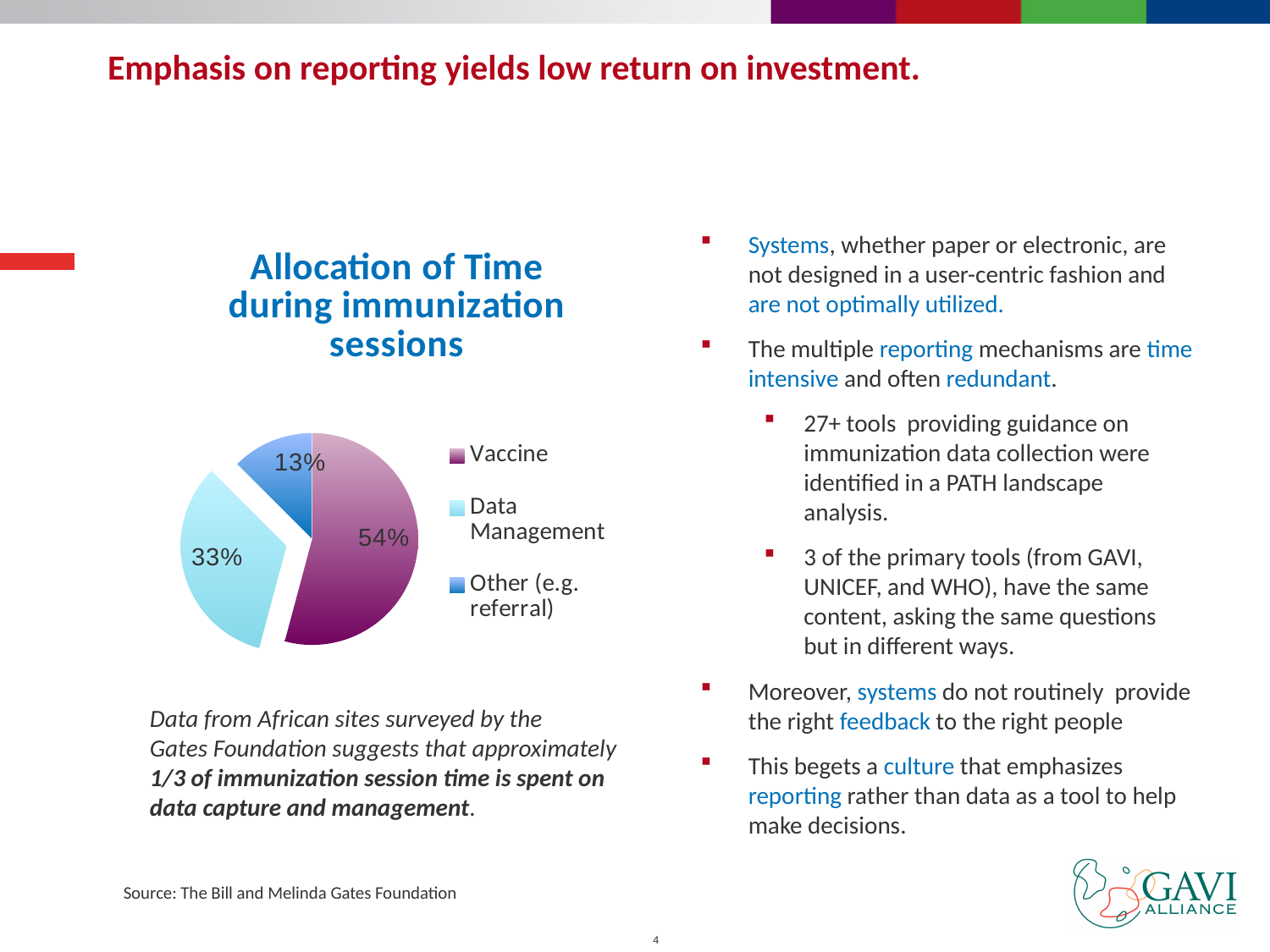
What share of time is allocated to Vaccine? 54% Which category takes the smallest share of time? Other (e.g. referral) What share of time is allocated to Other (e.g. referral)? 13% What is the title of the chart? Allocation of Time during immunization sessions Which category takes the largest share of time? Vaccine How many entries does the legend list? 3 What type of chart is shown on the slide? Pie chart Which is larger, the share for Data Management or the share for Other (e.g. referral)? Data Management What is the difference in percentage points between Vaccine and Data Management? 21 What is the combined share of Data Management and Other (e.g. referral)? 46% What share of time is allocated to Data Management? 33% How many categories does the pie chart show? 3